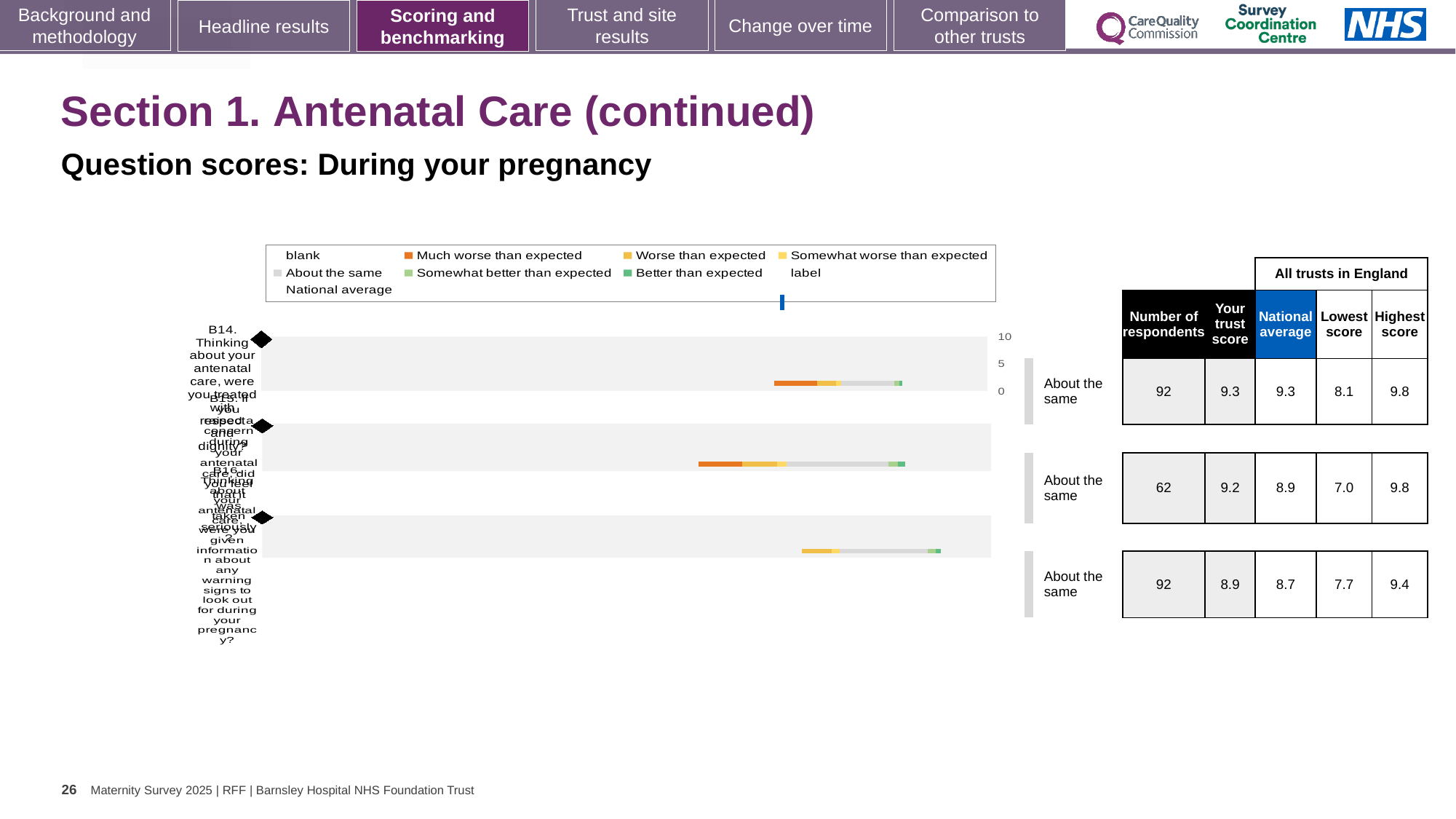
What colour represents 'Much worse than expected' in the chart legend? orange Which question row has the highest 'Your trust score' in the table? B14 In the table beside the chart, what is 'Your trust score' for question B14 (treated with respect and dignity)? 9.3 What is the 'Highest score' listed for question B16 (warning signs information)? 9.4 How many entries does the chart legend list? 9 What benchmark category is shown for question B16 (warning signs information)? About the same For question B16 (warning signs information), which is larger: 'Your trust score' or the 'National average'? Your trust score How many question rows (bars) are plotted in the chart? 3 What kind of chart is shown on the slide? bar chart For question B15, what is the difference between 'Your trust score' and the 'National average'? 0.3 In the table beside the chart, how many respondents are listed for question B15 (concern taken seriously)? 62 Which question row has the lowest 'Lowest score' value in the table? B15